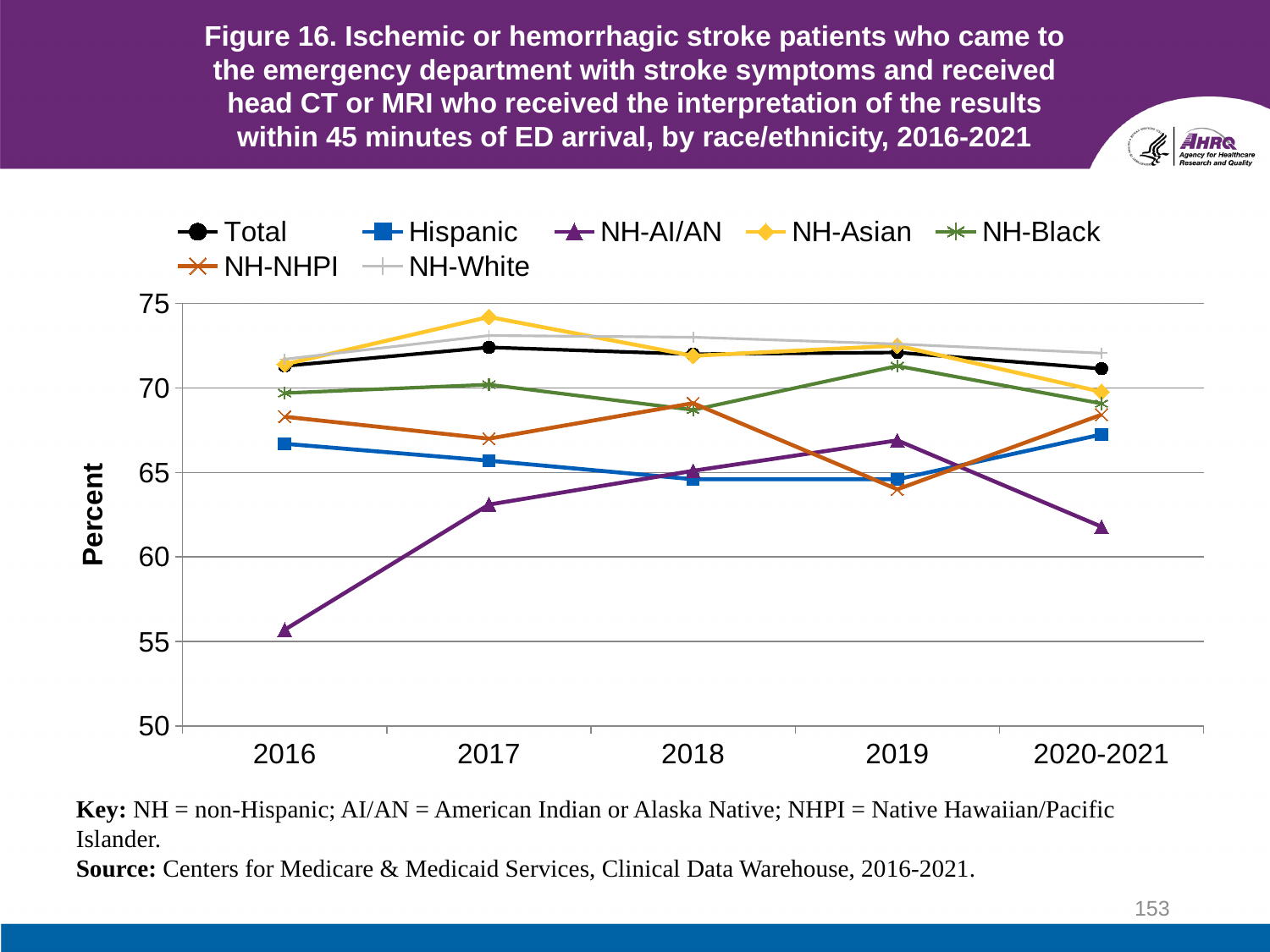
Is the value for NH-Asian in 2017 greater or less than 70? greater Which race/ethnicity group had the lowest value in 2016? NH-AI/AN What kind of chart is shown on the slide? line chart How many time periods are shown on the x axis? 5 Is the value for Hispanic in 2016 greater or less than 65? greater In 2019, which is larger: the value for NH-AI/AN or the value for NH-NHPI? NH-AI/AN Which series had the lowest value in 2020-2021? NH-AI/AN Which series had the highest value in 2017? NH-Asian How many series does the legend list? 7 Did the value for NH-AI/AN rise or fall from 2016 to 2019? rise Is the value for NH-AI/AN in 2016 greater or less than 60? less